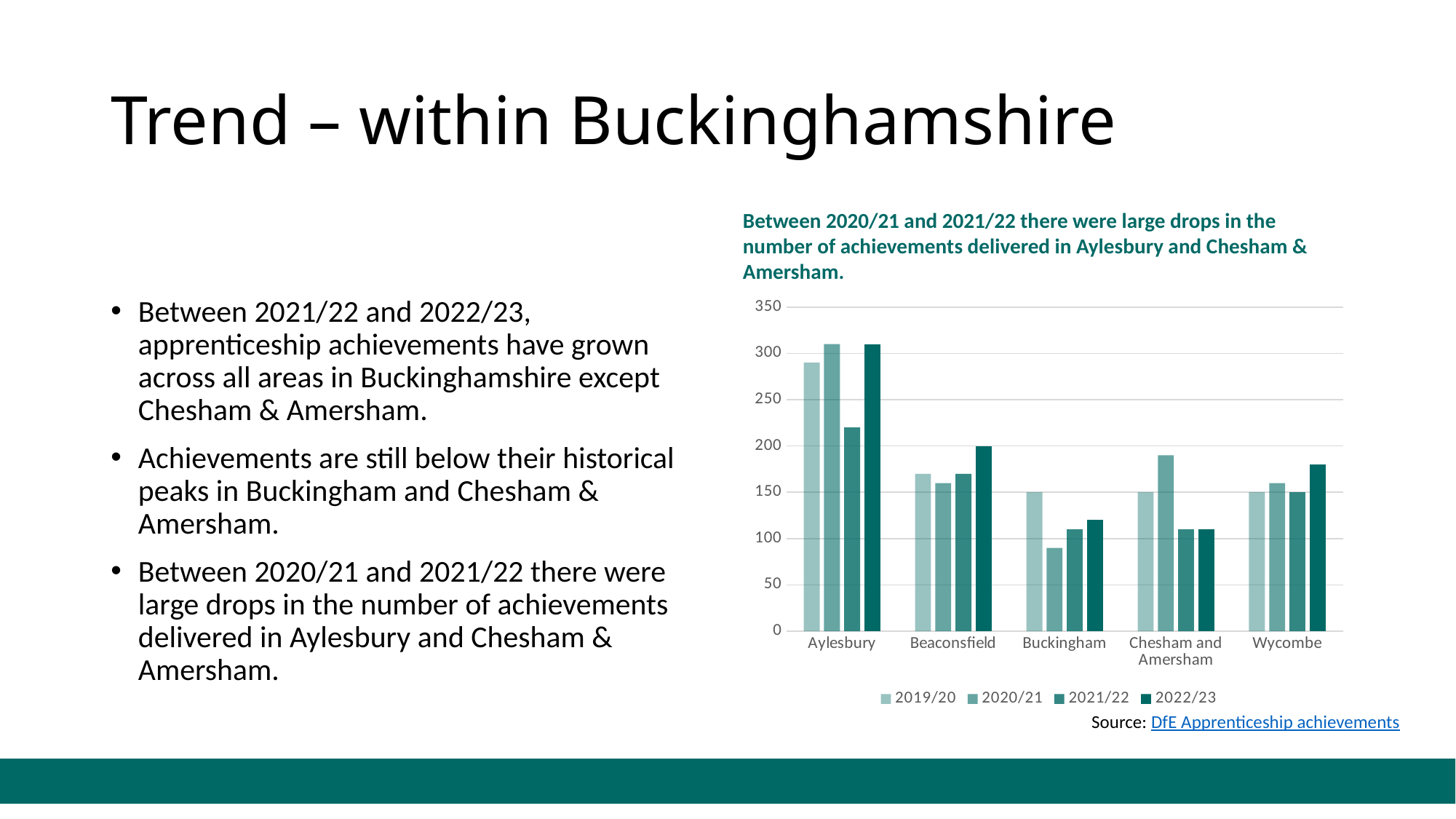
Which area has the highest bars overall in the chart? Aylesbury How many series does the chart's legend list? 4 Which is larger for Chesham and Amersham: 2020/21 or 2021/22? 2020/21 Which year is shown by the darkest bars in the legend? 2022/23 Is the value for Aylesbury in 2020/21 greater or less than 300? greater Is the value for Buckingham in 2020/21 greater or less than 100? less How many areas (categories) are shown on the x axis of the chart? 5 Which area and year has the lowest bar in the chart? Buckingham, 2020/21 What kind of chart is shown on the slide? Bar chart Is the value for Aylesbury in 2021/22 greater or less than 250? less Which is larger in 2022/23: Beaconsfield or Buckingham? Beaconsfield